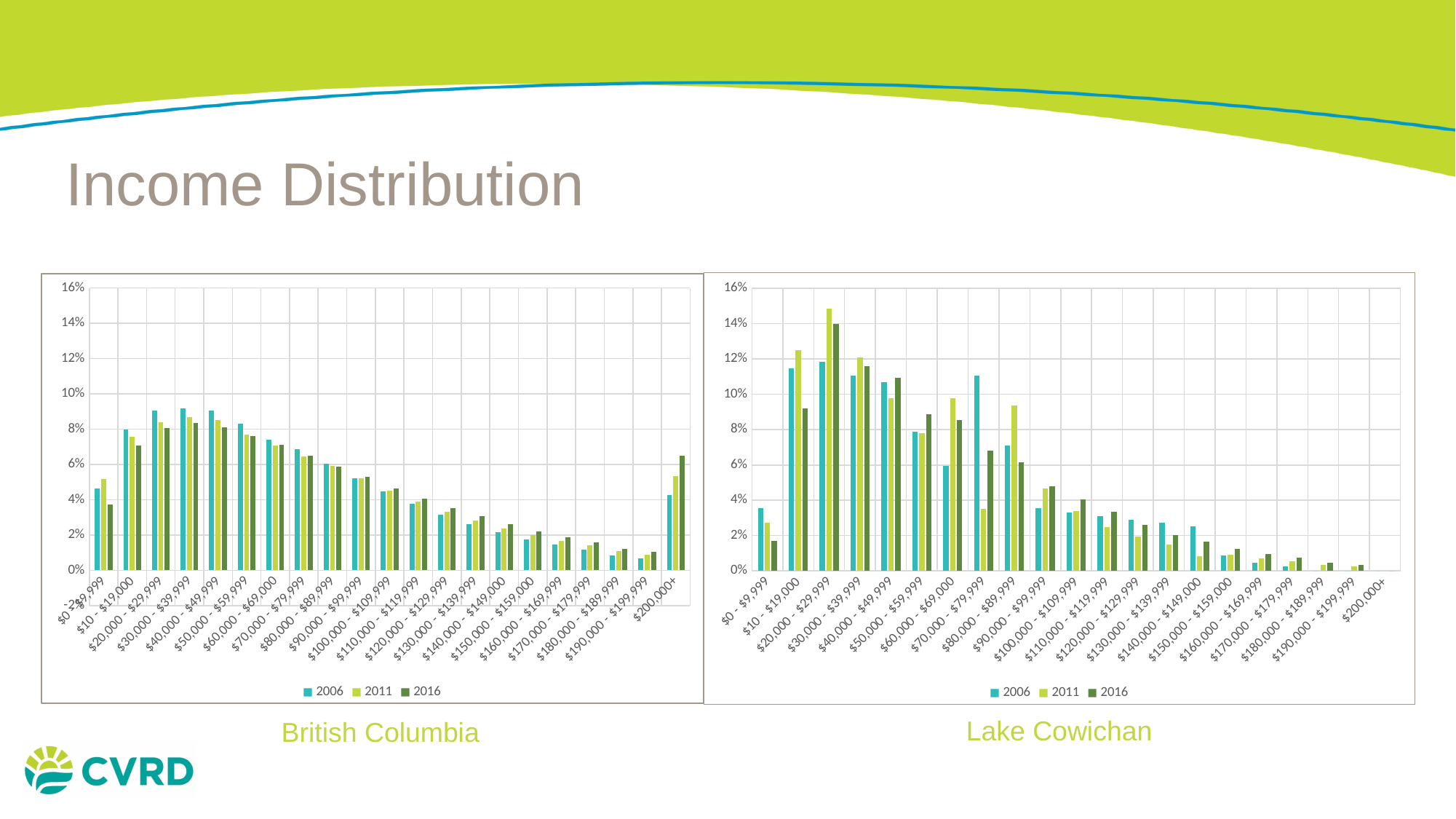
In the Lake Cowichan chart, is the 2011 value for $20,000 - $29,999 greater or less than 14%? greater What kind of chart is the British Columbia chart? bar chart In the Lake Cowichan chart, is the 2006 value for $70,000 - $79,999 greater or less than 10%? greater In the British Columbia chart, do the 2006 values generally rise or fall from $40,000 - $49,999 to $190,000 - $199,999? fall In the British Columbia chart, is the 2016 value for $0 - $9,999 greater or less than 4%? less In the Lake Cowichan chart, which is larger for $70,000 - $79,999, the 2006 value or the 2011 value? 2006 What are the legend entries of the British Columbia chart? 2006, 2011, 2016 In the British Columbia chart, which is larger for $200,000+, the 2006 value or the 2016 value? 2016 How many series does the legend of the Lake Cowichan chart list? 3 In the Lake Cowichan chart, which income category has the highest bar overall? $20,000 - $29,999 How many income categories are shown on the x axis of the British Columbia chart? 21